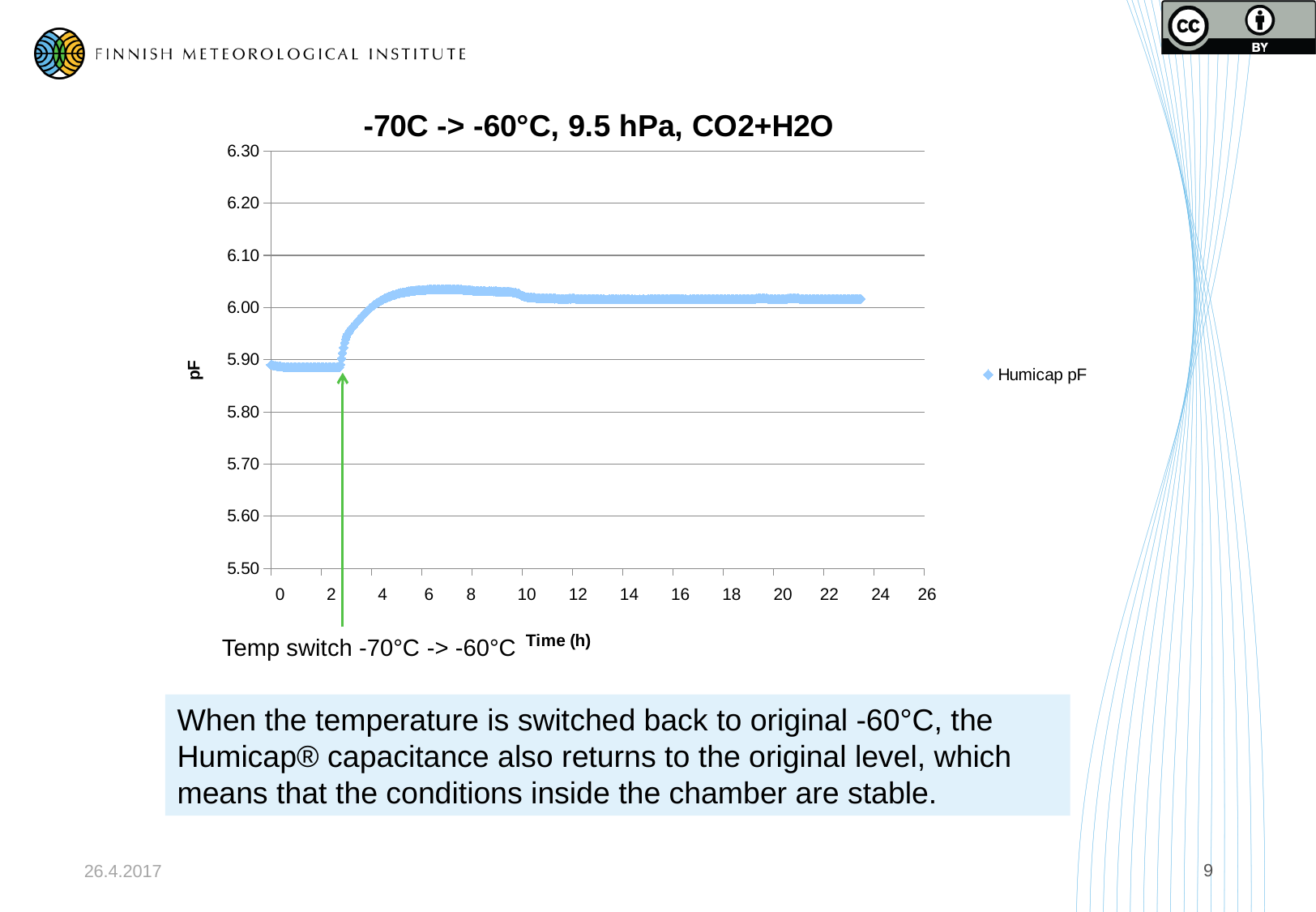
What is the name of the series shown in the chart legend? Humicap pF What kind of chart is shown on the slide? scatter chart Is the Humicap pF value at time 1 h greater or less than 5.80? greater What is the title of the chart? -70C -> -60°C, 9.5 hPa, CO2+H2O Which is larger, the Humicap pF value at time 1 h or at time 6 h? time 6 h How many series does the chart legend list? 1 Is the Humicap pF value at time 1 h greater or less than 6.00? less What is the highest value shown on the pF axis? 6.30 Is the Humicap pF value at time 6 h greater or less than 6.00? greater Does the Humicap pF value rise or fall between time 2 h and time 6 h? rise Which is larger, the Humicap pF value at time 6 h or at time 20 h? time 6 h